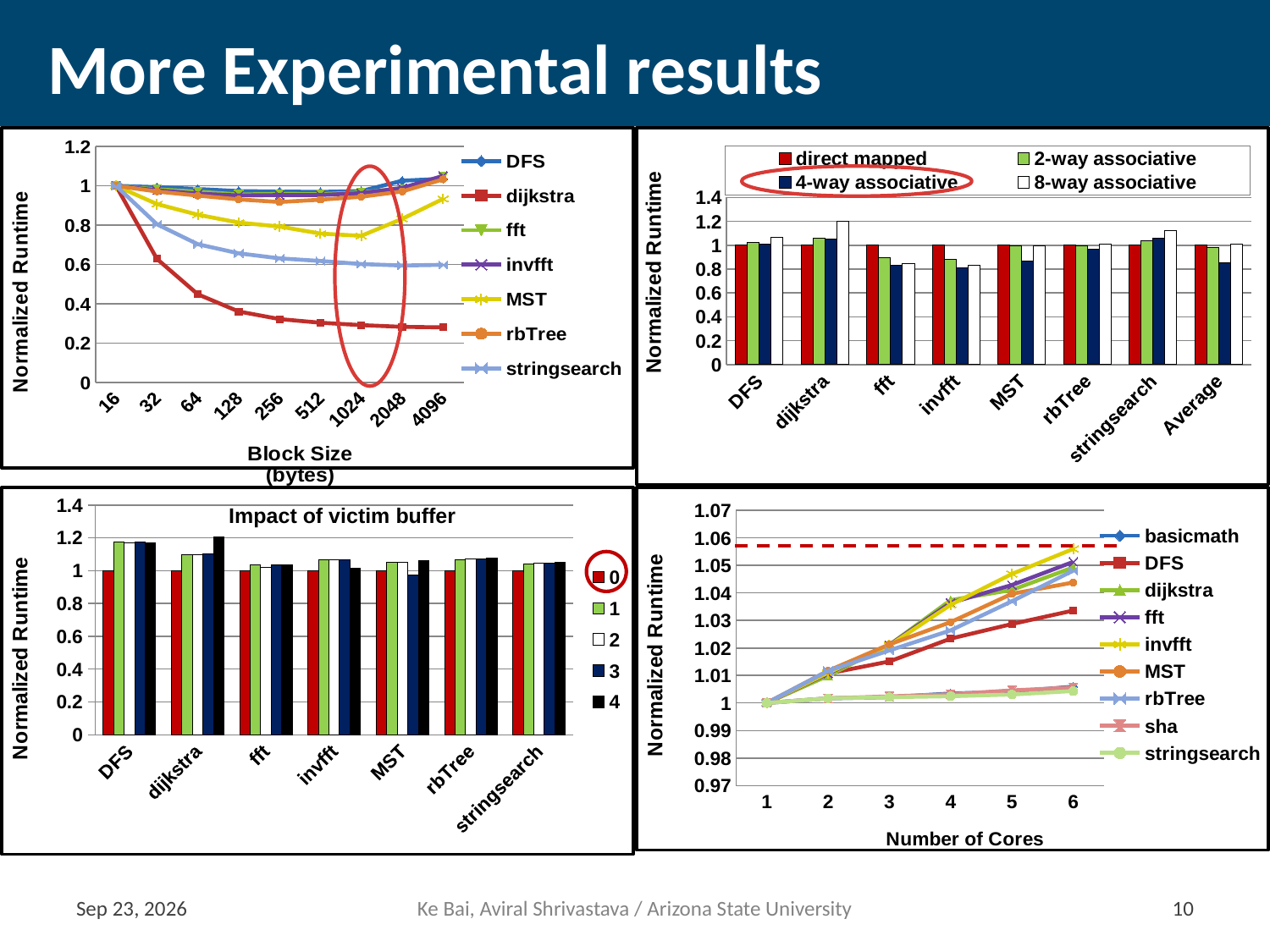
How many series does the legend of the top-left chart (Block Size) list? 7 In the bottom-right chart, does the basicmath line rise or fall as the number of cores increases? rise In the top-left chart, which series has the lowest normalized runtime at block size 4096? dijkstra What kind of chart is the 'Impact of victim buffer' chart? bar chart How many series does the legend of the bottom-right chart (Number of Cores) list? 9 How many categories are shown on the x axis of the top-right bar chart (direct mapped / associative)? 8 In the top-right bar chart, is the 8-way associative value for dijkstra greater or less than 1? greater In the top-right bar chart, which category has the highest 8-way associative bar? dijkstra What kind of chart is the top-left chart (Normalized Runtime vs Block Size)? line chart How many block sizes are shown on the x axis of the top-left chart? 9 In the top-left chart, does the dijkstra line rise or fall as block size increases? fall In the top-left chart, is the value for dijkstra at block size 4096 greater or less than 0.4? less